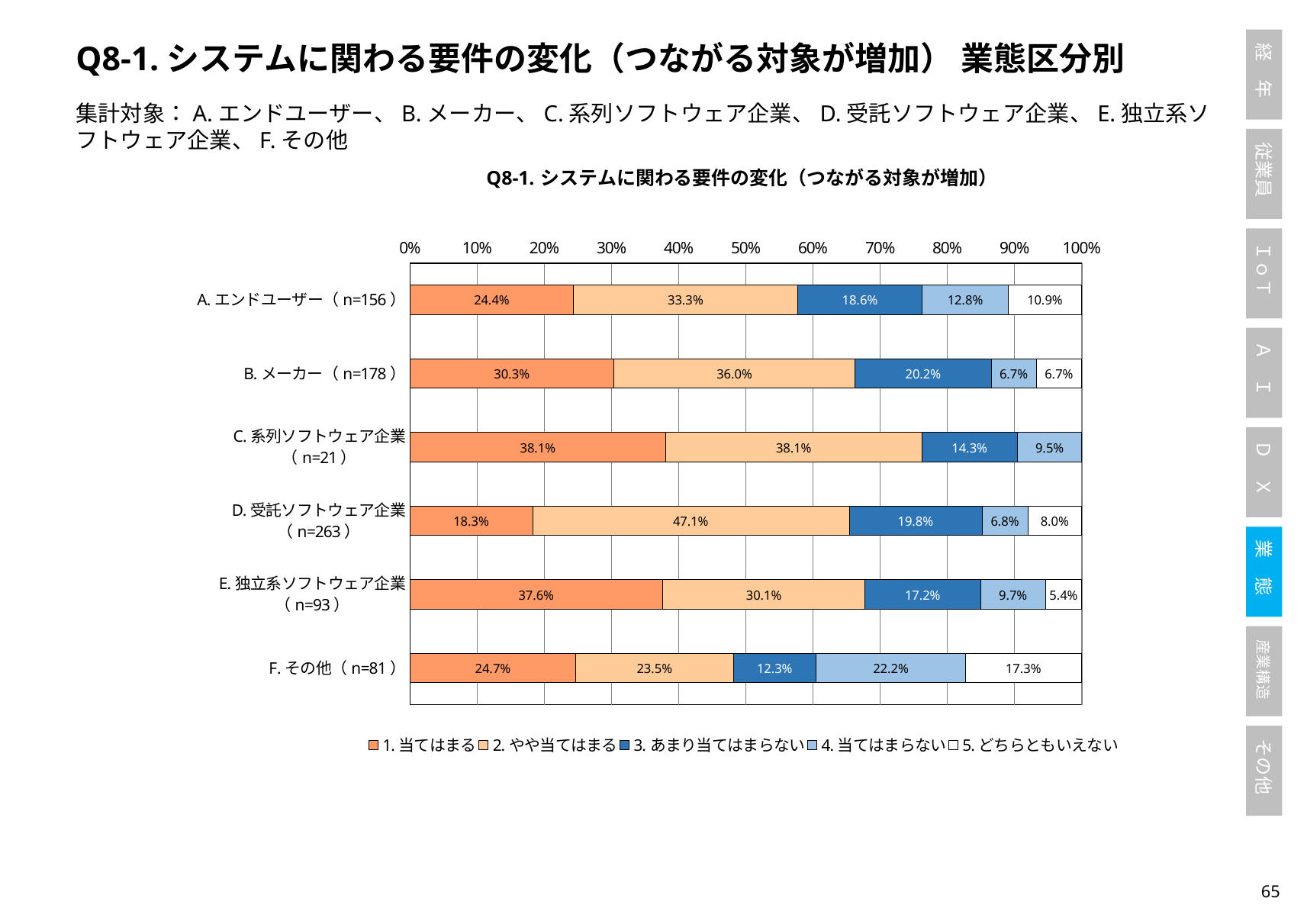
「3. あまり当てはまらない」の値は、B. メーカーとE. 独立系ソフトウェア企業のどちらが大きいですか？ B. メーカー 「1. 当てはまる」の割合が最も高い業態区分はどれですか？ C. 系列ソフトウェア企業 「1. 当てはまる」の割合が最も低い業態区分はどれですか？ D. 受託ソフトウェア企業 A. エンドユーザー（n=156）の「1. 当てはまる」の値は何%ですか？ 24.4% F. その他（n=81）の「4. 当てはまらない」の値は何%ですか？ 22.2% このグラフには業態区分がいくつありますか？ 6 このグラフの種類は何ですか？ 積み上げ横棒グラフ 「2. やや当てはまる」について、B. メーカーとF. その他の値の差は何ポイントですか？ 12.5ポイント A. エンドユーザーの「1. 当てはまる」と「2. やや当てはまる」の合計は何%ですか？ 57.7% D. 受託ソフトウェア企業（n=263）の「2. やや当てはまる」の値は何%ですか？ 47.1% 凡例には系列がいくつ示されていますか？ 5 凡例の5番目の項目は何ですか？ 5. どちらともいえない